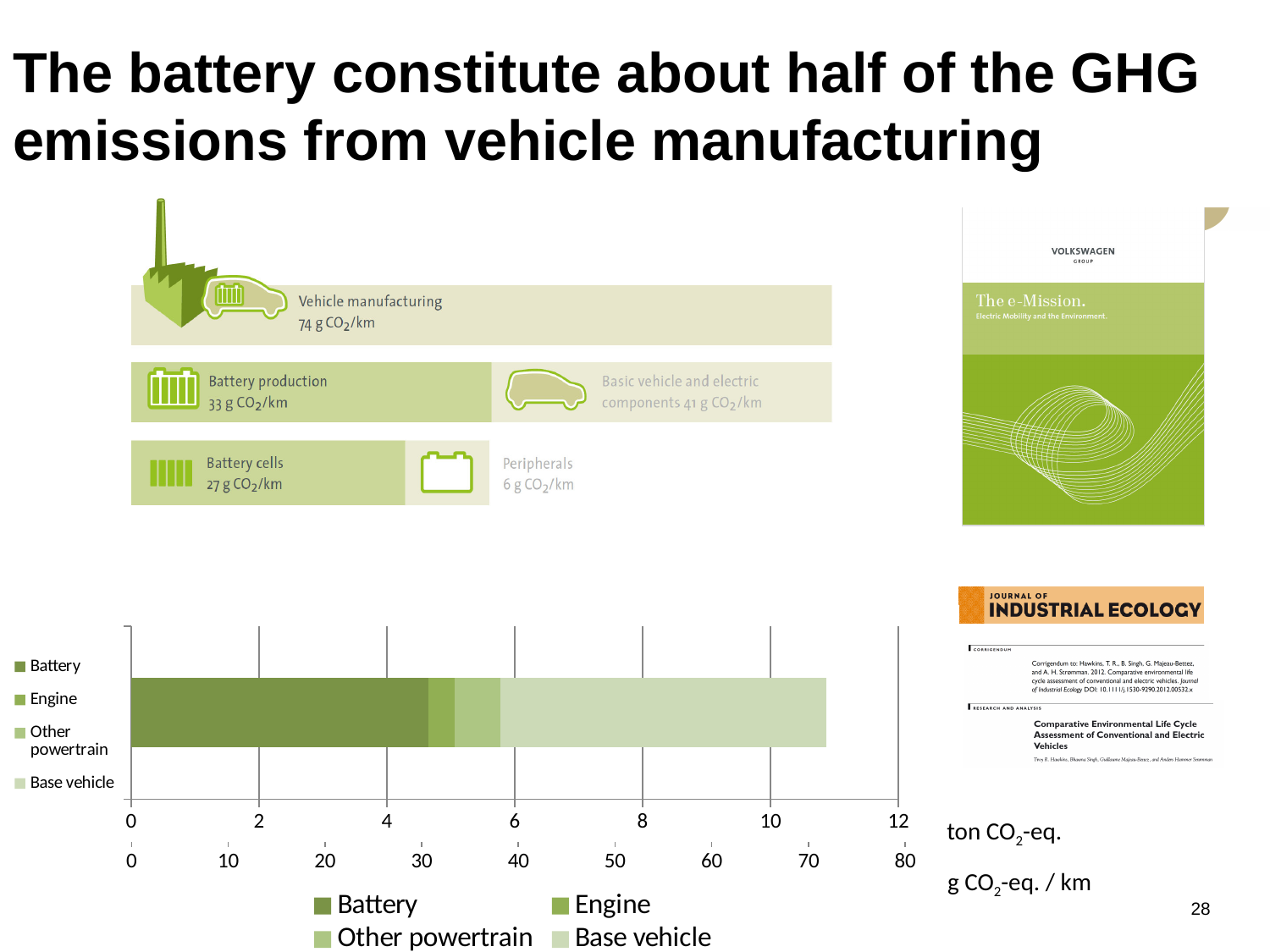
What kind of chart is the chart at the bottom of the slide? Stacked bar chart In the infographic at the top of the slide, what is the value for Vehicle manufacturing? 74 g CO2/km In the bar chart at the bottom of the slide, is the total length of the stacked bar greater or less than 12 ton CO2-eq? less In the bar chart at the bottom of the slide, which segment is larger, Battery or Engine? Battery In the bar chart at the bottom of the slide, is the total length of the stacked bar greater or less than 10 ton CO2-eq? greater In the bar chart at the bottom of the slide, how many series does the legend list? 4 In the bar chart at the bottom of the slide, is the Battery segment greater or less than 4 ton CO2-eq? greater In the infographic at the top of the slide, what is the difference between Basic vehicle and electric components (41 g CO2/km) and Battery production (33 g CO2/km)? 8 g CO2/km In the bar chart at the bottom of the slide, how many bars are plotted? 1 In the bar chart at the bottom of the slide, what unit is shown for the lower (secondary) horizontal axis? g CO2-eq. / km In the infographic at the top of the slide, what is the value for Battery cells? 27 g CO2/km In the bar chart at the bottom of the slide, which segment is the smallest? Engine